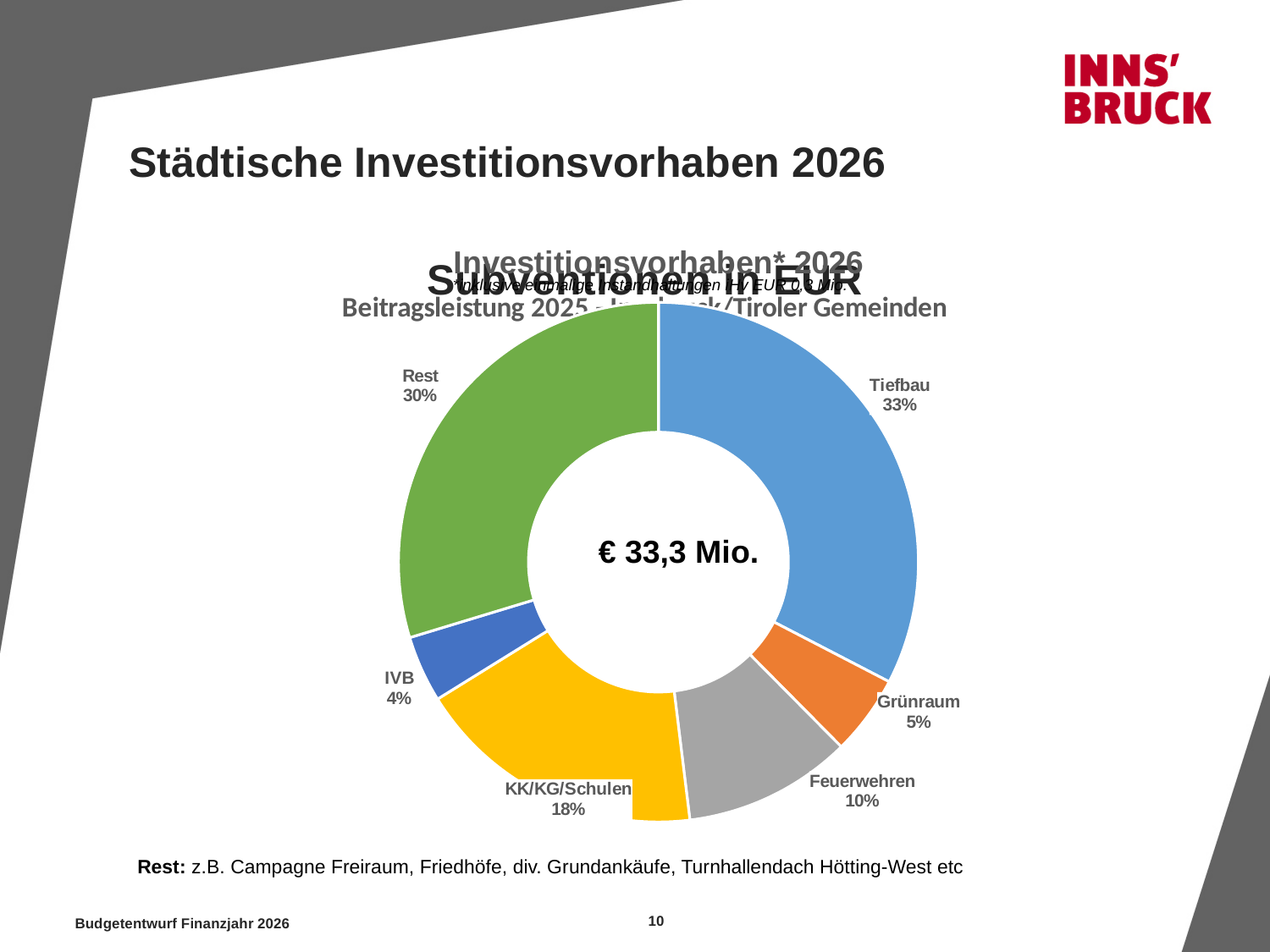
What is the difference in percentage points between Tiefbau and Rest? 3 percentage points Which category has the largest share in the chart? Tiefbau Which category has the smallest share in the chart? IVB Which is larger in the chart, Grünraum or Feuerwehren? Feuerwehren What percentage is shown for Feuerwehren in the chart? 10% What percentage is shown for KK/KG/Schulen in the chart? 18% How many categories are shown in the doughnut chart? 6 What is the combined share of KK/KG/Schulen and IVB? 22% What type of chart is shown on the slide? Doughnut chart What share does IVB have in the chart? 4% What share of the doughnut chart does Tiefbau account for? 33% What total amount is printed in the centre of the chart? € 33,3 Mio.